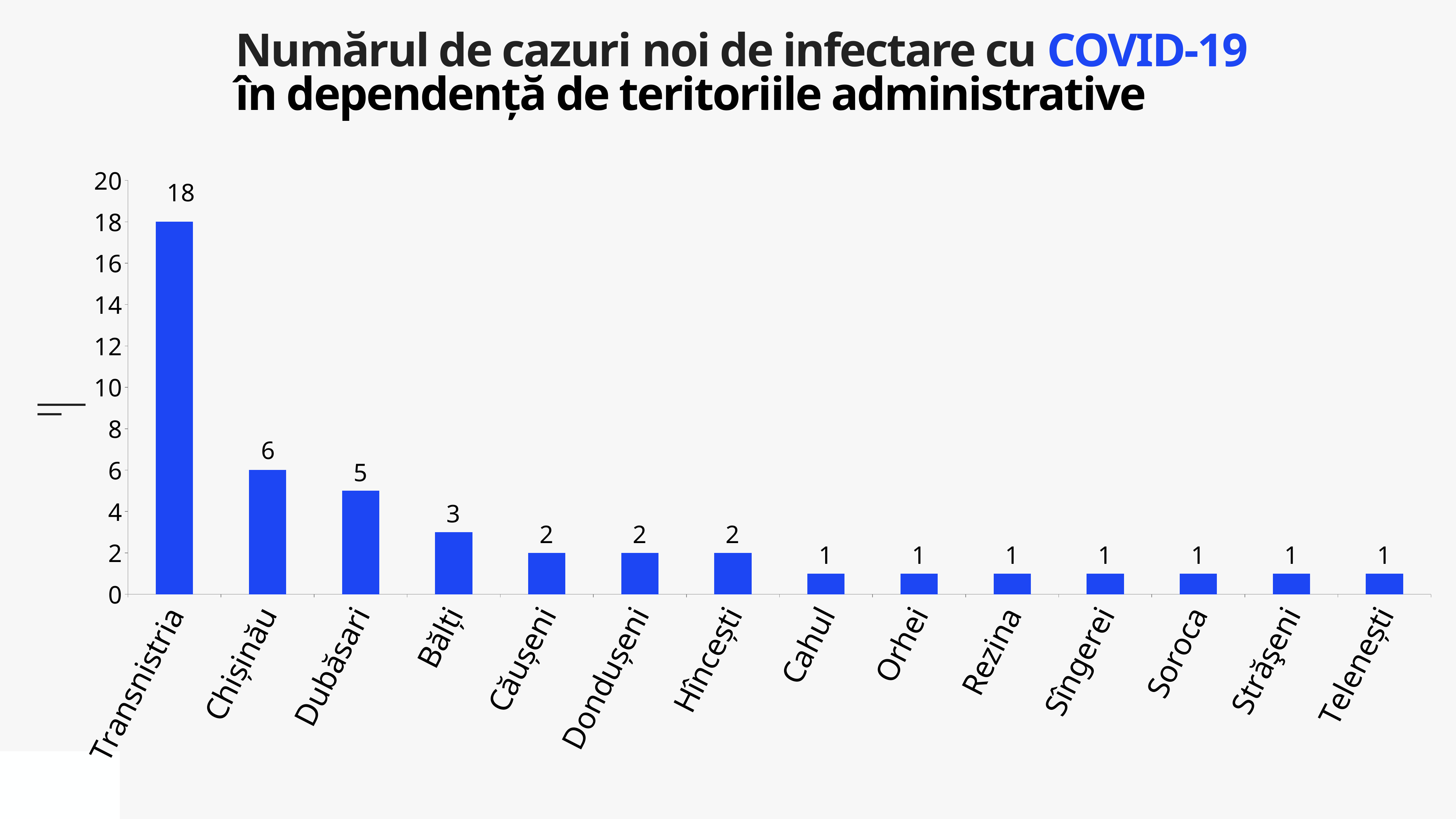
What is the difference between the values for Transnistria and Chișinău? 12 What kind of chart is shown on the slide? bar chart What is the value for Transnistria? 18 Is the value for Transnistria greater or less than 10? greater Which territory has the highest number of new cases? Transnistria What is the difference between the values for Dubăsari and Bălți? 2 What is the value for Bălți? 3 What is the value for Hîncești? 2 What is the value for Chișinău? 6 How many territories are shown on the x axis? 14 Which is larger, the value for Chișinău or the value for Dubăsari? Chișinău What is the value for Dubăsari? 5